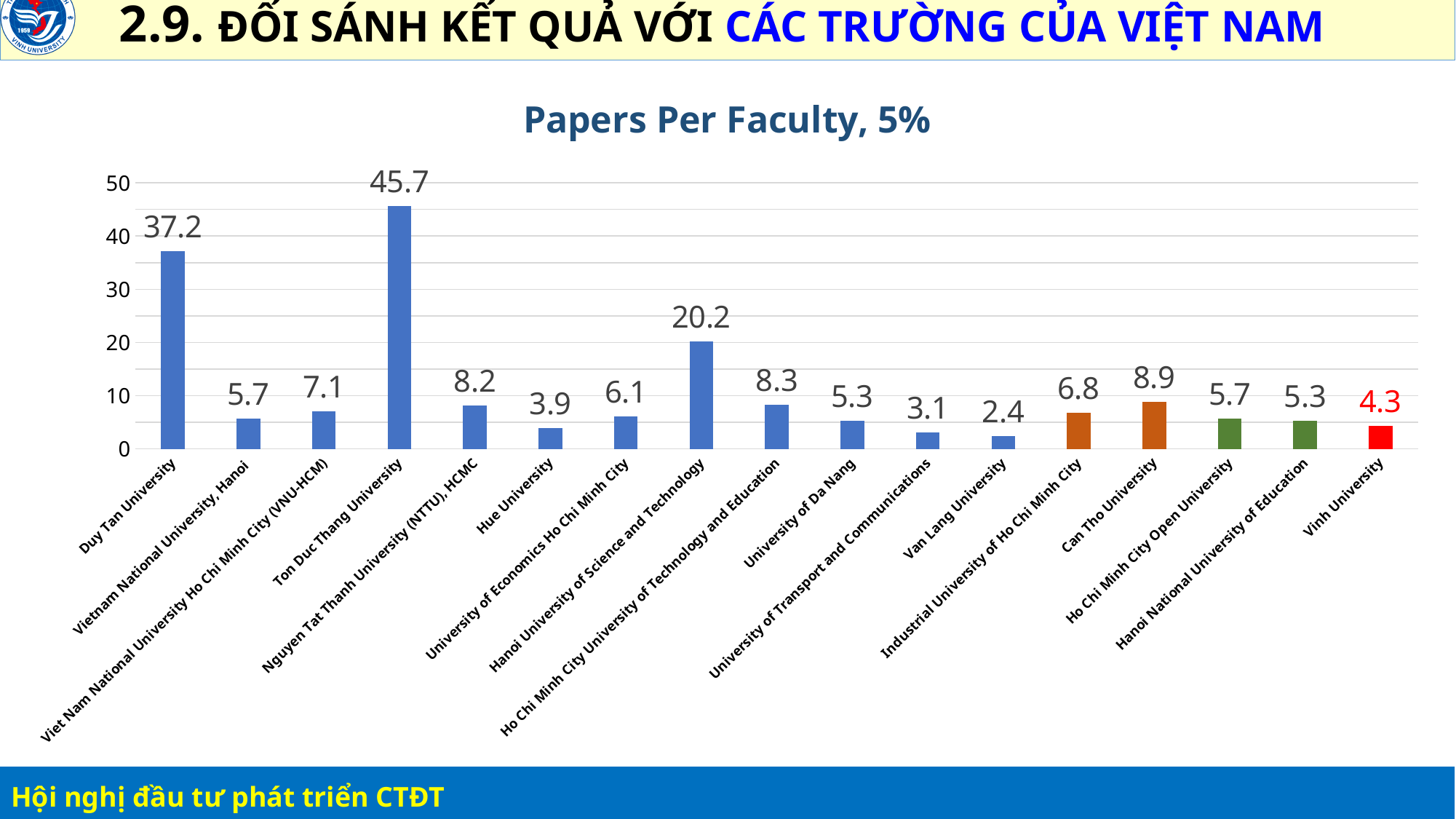
Which university has the highest value? Ton Duc Thang University What is the value for Ton Duc Thang University? 45.7 What kind of chart is this? Bar chart What is the difference between the values for Can Tho University and Vinh University? 4.6 What is the value for Hanoi University of Science and Technology? 20.2 How many universities are shown on the chart? 17 Which is larger, the value for Hue University or the value for University of Economics Ho Chi Minh City? University of Economics Ho Chi Minh City What is the value for Vinh University? 4.3 What is the title of the chart? Papers Per Faculty, 5% What is the value for Can Tho University? 8.9 Which university has the lowest value? Van Lang University What is the difference between the values for Ton Duc Thang University and Duy Tan University? 8.5